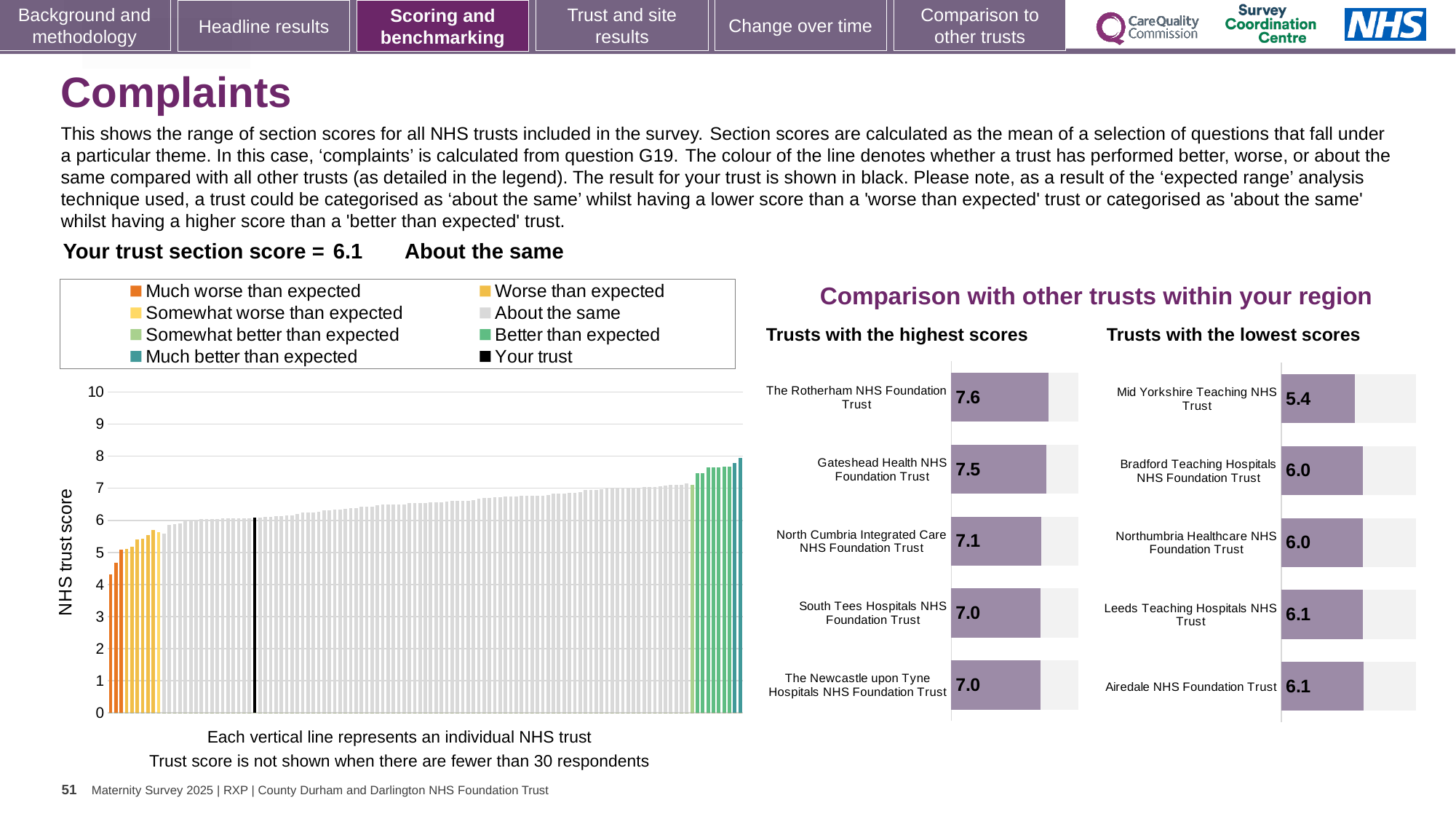
In the 'Trusts with the highest scores' chart, what is the difference between the scores of The Rotherham NHS Foundation Trust and North Cumbria Integrated Care NHS Foundation Trust? 0.5 In the 'Trusts with the lowest scores' chart, what is the difference between the scores of Leeds Teaching Hospitals NHS Trust and Mid Yorkshire Teaching NHS Trust? 0.7 In the NHS trust score chart on the left, is the value for the black 'Your trust' bar greater or less than 5? greater In the 'Trusts with the highest scores' chart, which trust has the highest score? The Rotherham NHS Foundation Trust How many entries does the legend of the NHS trust score chart on the left list? 8 In the 'Trusts with the lowest scores' chart, which trust has the lowest score? Mid Yorkshire Teaching NHS Trust In the 'Trusts with the highest scores' chart, what is the score for The Rotherham NHS Foundation Trust? 7.6 What kind of chart is the NHS trust score chart on the left? Bar chart In the NHS trust score chart on the left, is the value of the lowest bar greater or less than 5? less How many trusts are shown in the 'Trusts with the highest scores' chart? 5 In the 'Trusts with the lowest scores' chart, which has the larger score: Bradford Teaching Hospitals NHS Foundation Trust or Mid Yorkshire Teaching NHS Trust? Bradford Teaching Hospitals NHS Foundation Trust In the 'Trusts with the lowest scores' chart, what is the score for Mid Yorkshire Teaching NHS Trust? 5.4